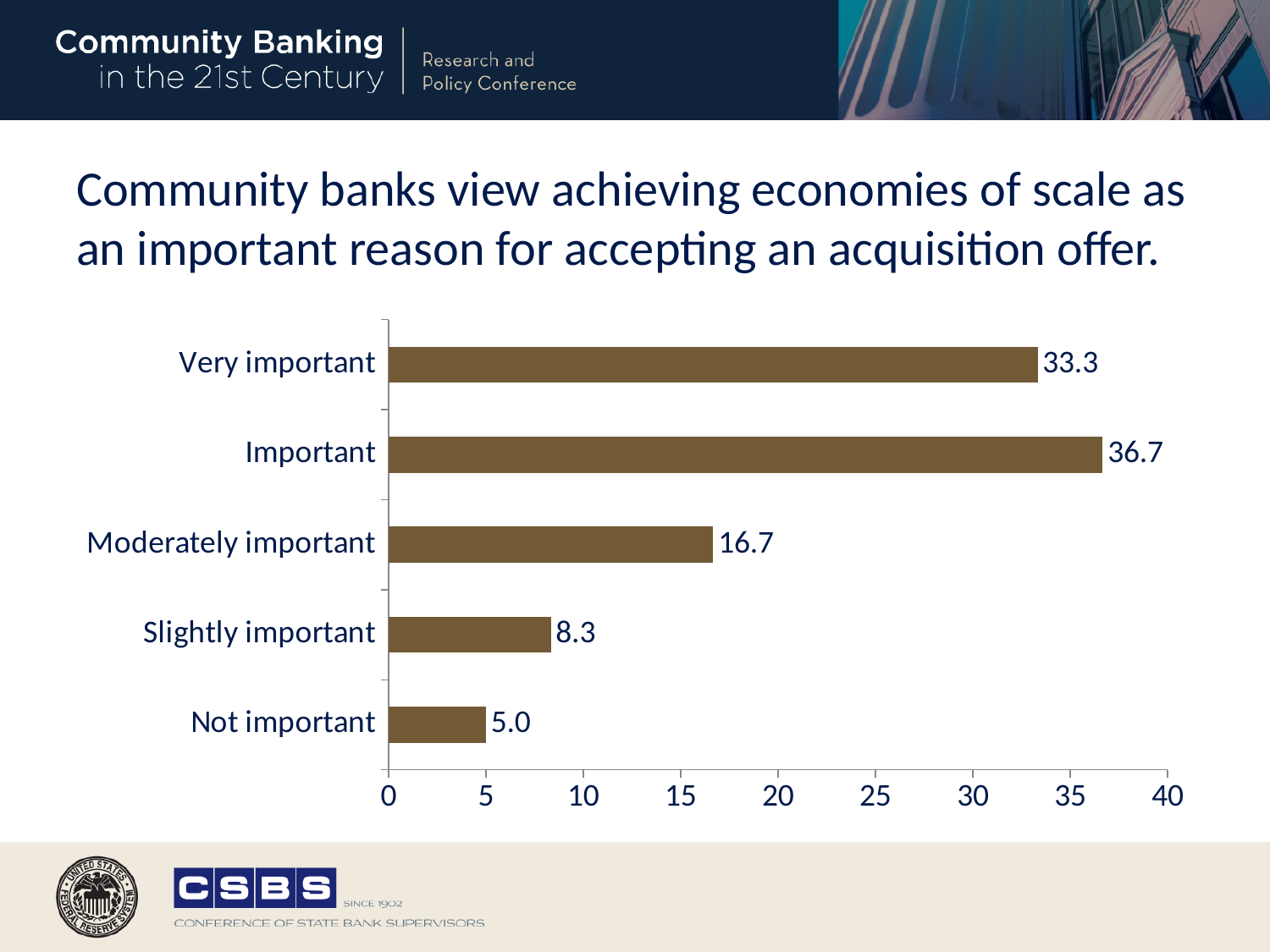
What is the value for Important? 36.7 What is the difference between the values for Moderately important and Slightly important? 8.4 What is the difference between the values for Important and Very important? 3.4 Which is larger, the value for Very important or the value for Moderately important? Very important What kind of chart is shown on the slide? Bar chart How many categories are shown in the chart? 5 Which category has the highest value? Important Which category has the lowest value? Not important What is the value for Not important? 5.0 What is the value for Slightly important? 8.3 What is the value for Moderately important? 16.7 What is the value for Very important? 33.3